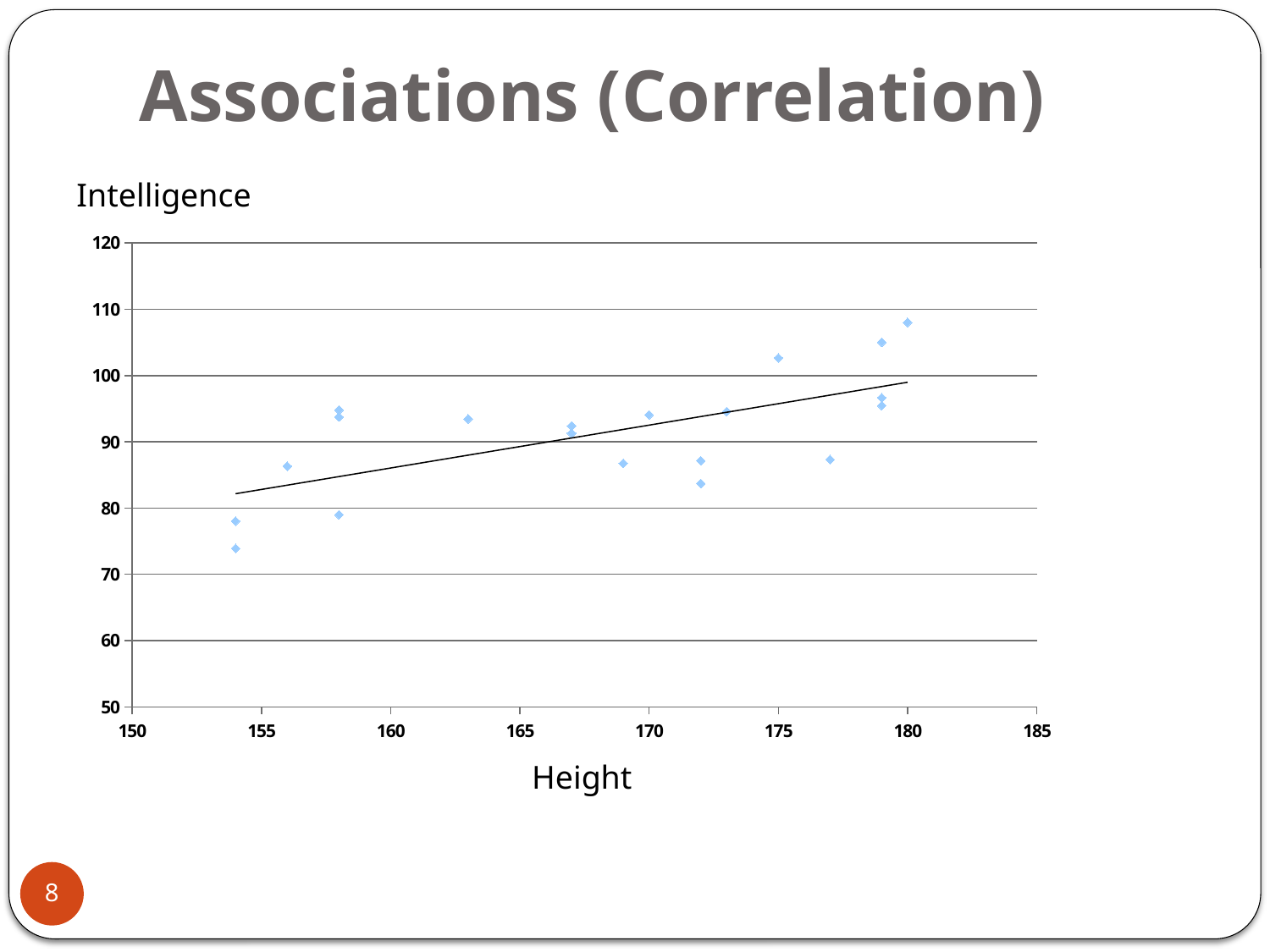
What is the title of the slide containing the chart? Associations (Correlation) What is the maximum value shown on the vertical (Intelligence) axis? 120 Is the Intelligence value for the point at Height 170 greater or less than 90? greater What kind of chart is shown on the slide? scatter plot Is the highest Intelligence value plotted (at Height 180) greater or less than 100? greater What variable is plotted on the horizontal axis? Height Is the Intelligence value for the point at Height 163 greater or less than 90? greater Does the trend line rise or fall as Height increases? rises Which has the higher Intelligence value: the point at Height 180 or the point at Height 156? Height 180